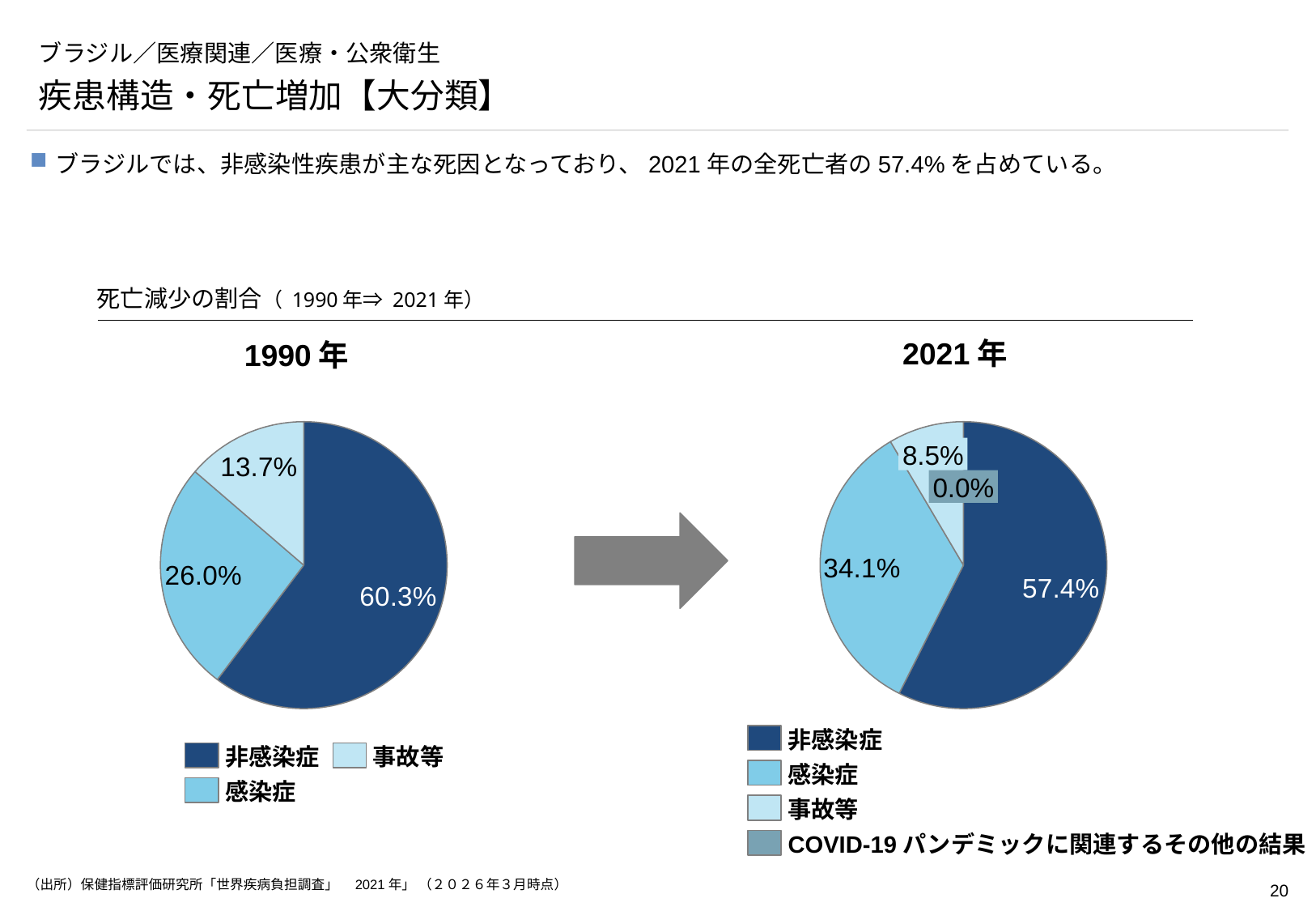
What type of chart is used for the 1990年 and 2021年 data? Pie chart In the 1990年 pie chart, what share is shown for 非感染症? 60.3% In the 1990年 pie chart, which category has the smallest share? 事故等 Which is larger: the 事故等 share in the 1990年 chart or the 事故等 share in the 2021年 chart? 1990年 In the 2021年 pie chart, what share is shown for COVID-19 パンデミックに関連するその他の結果? 0.0% In the 2021年 pie chart, which category has the largest share? 非感染症 In the 1990年 pie chart, what share is shown for 感染症? 26.0% What is the difference between the 感染症 share in the 2021年 chart and the 感染症 share in the 1990年 chart? 8.1% In the 2021年 pie chart, what share is shown for 非感染症? 57.4% In the 2021年 pie chart, what share is shown for 感染症? 34.1% How many categories does the legend of the 2021年 pie chart list? 4 In the 1990年 pie chart, what share is shown for 事故等? 13.7%